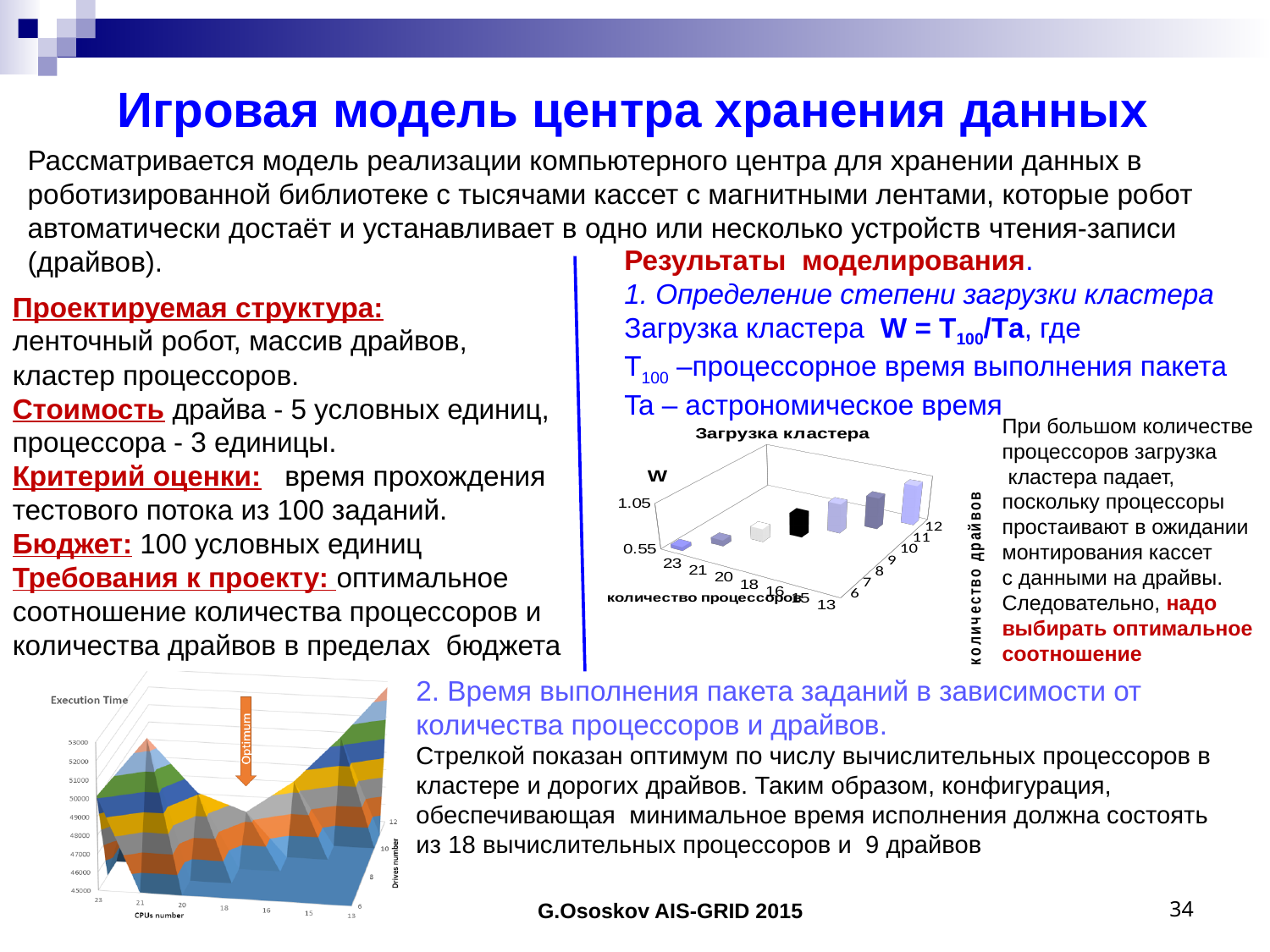
What kind of chart is the "Execution Time" chart in the lower left? surface chart In the "Загрузка кластера" chart, which number of processors has the lowest bar? 23 In the "Загрузка кластера" chart, is the value for 23 processors greater or less than 1.05? less What word is written on the arrow in the "Execution Time" chart? Optimum In the "Загрузка кластера" chart, which number of processors has the highest bar? 13 In the "Загрузка кластера" chart, how do the bars change moving from 23 processors on the left to 13 processors on the right? they rise What kind of chart is the "Загрузка кластера" chart? bar chart How many bars are plotted in the "Загрузка кластера" chart? 7 In the "Загрузка кластера" chart, which bar is taller: the one for 21 processors or the one for 15 processors? 15 processors In the "Execution Time" chart, at which CPUs number does the arrow mark the optimum (minimum execution time)? 18 What is the label of the horizontal axis of the "Загрузка кластера" chart? количество процессоров How many CPUs number tick values are shown on the x axis of the "Execution Time" chart? 7